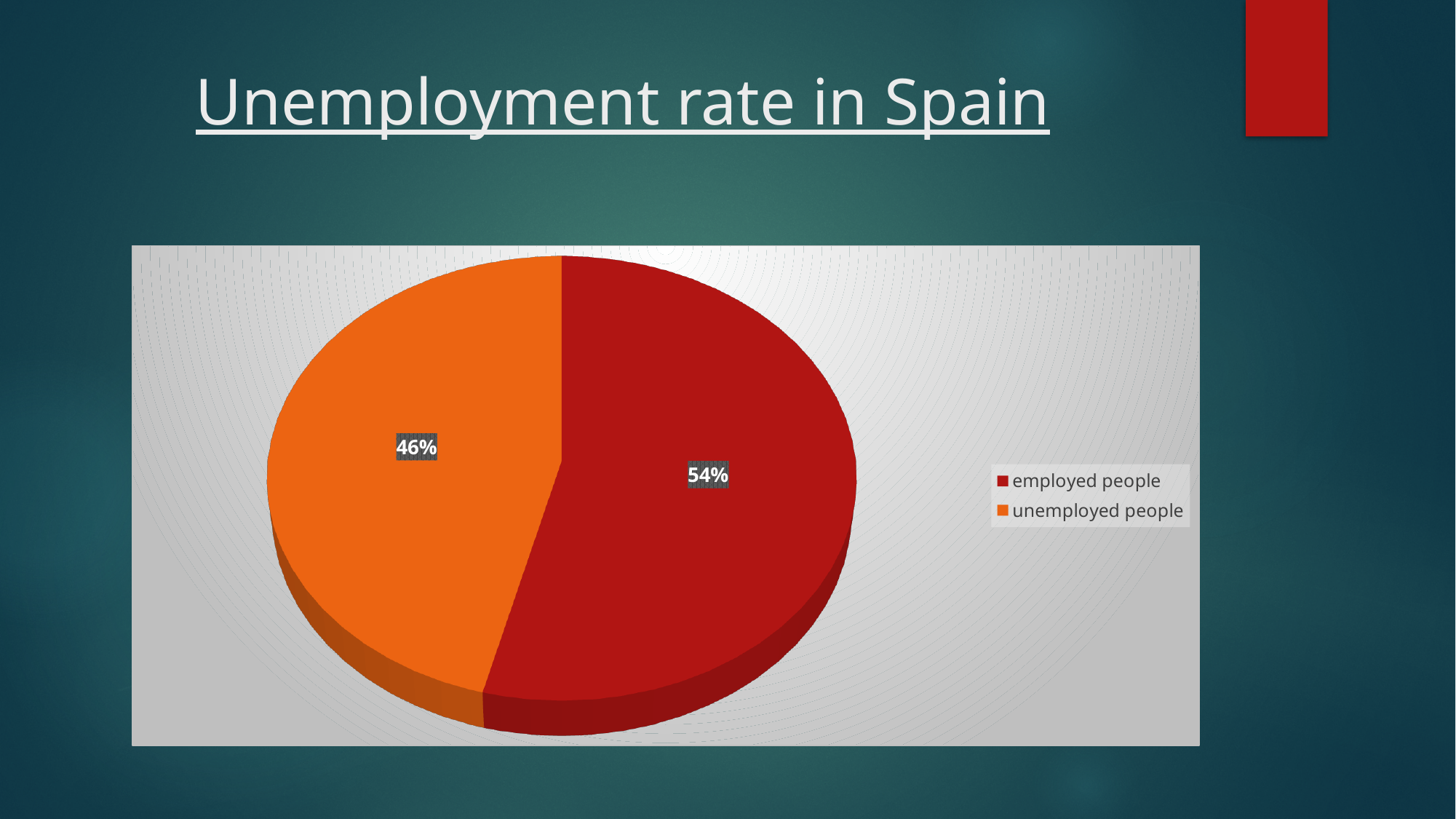
What colour is the slice for unemployed people? orange Which slice of the pie is the largest? employed people Which slice of the pie is the smallest? unemployed people What share of the pie is labelled for employed people? 54% What kind of chart is shown on the slide? pie chart How many slices does the pie chart have? 2 How many entries does the legend list? 2 What share of the pie is labelled for unemployed people? 46% Which is larger, the employed people slice or the unemployed people slice? employed people What is the difference in percentage points between the employed people slice and the unemployed people slice? 8 What is the title of the slide? Unemployment rate in Spain